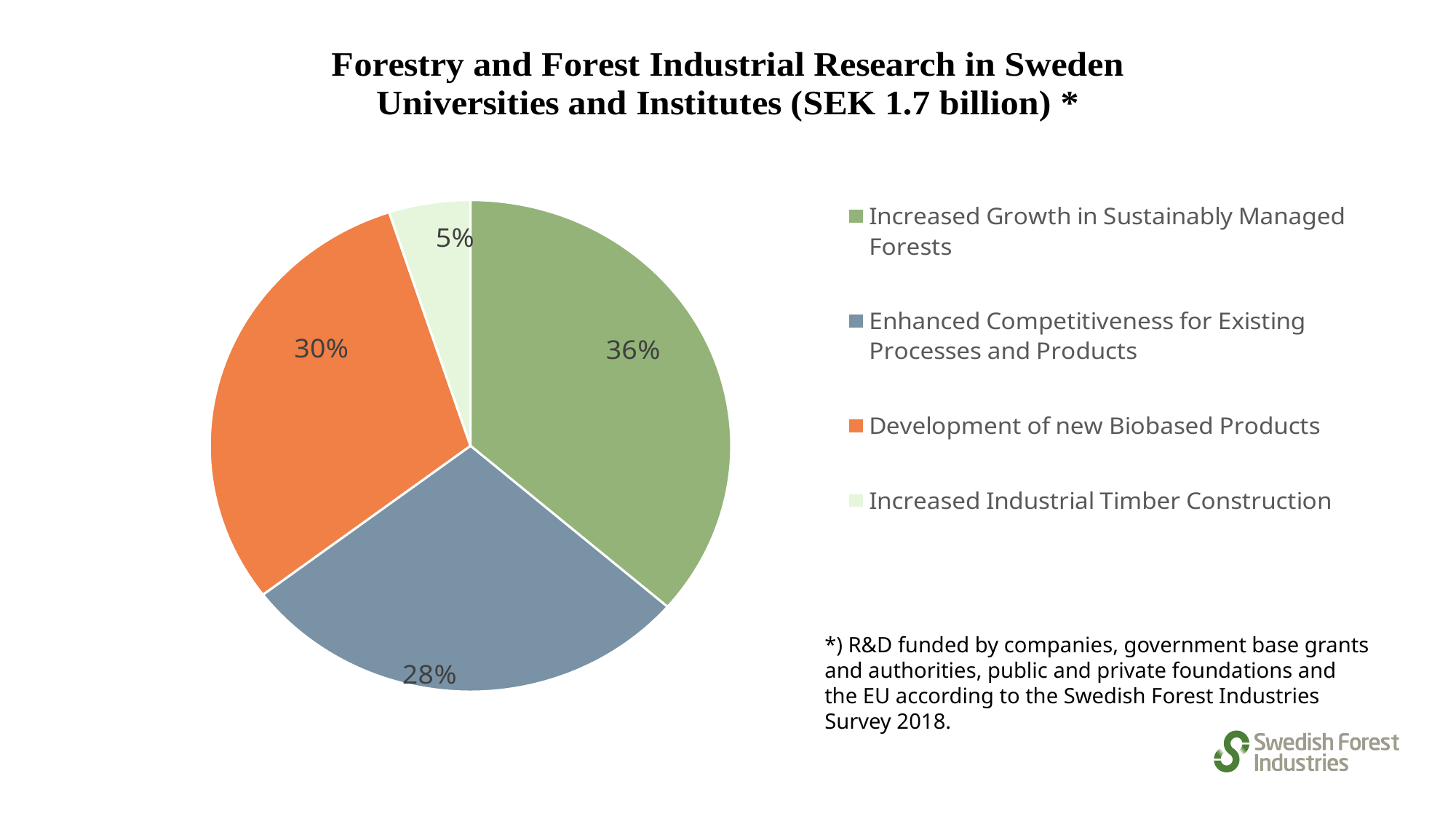
Which category has the largest slice of the pie? Increased Growth in Sustainably Managed Forests What kind of chart is shown on the slide? pie chart What share of the pie is Increased Growth in Sustainably Managed Forests? 36% What is the title of the chart? Forestry and Forest Industrial Research in Sweden Universities and Institutes (SEK 1.7 billion) * Which category has the smallest slice of the pie? Increased Industrial Timber Construction What is the difference in percentage points between Increased Growth in Sustainably Managed Forests and Increased Industrial Timber Construction? 31 percentage points What share of the pie is Increased Industrial Timber Construction? 5% Which colour represents Development of new Biobased Products in the legend? orange What share of the pie is Enhanced Competitiveness for Existing Processes and Products? 28% How many categories does the pie chart have? 4 Which is larger: the share for Development of new Biobased Products or the share for Enhanced Competitiveness for Existing Processes and Products? Development of new Biobased Products